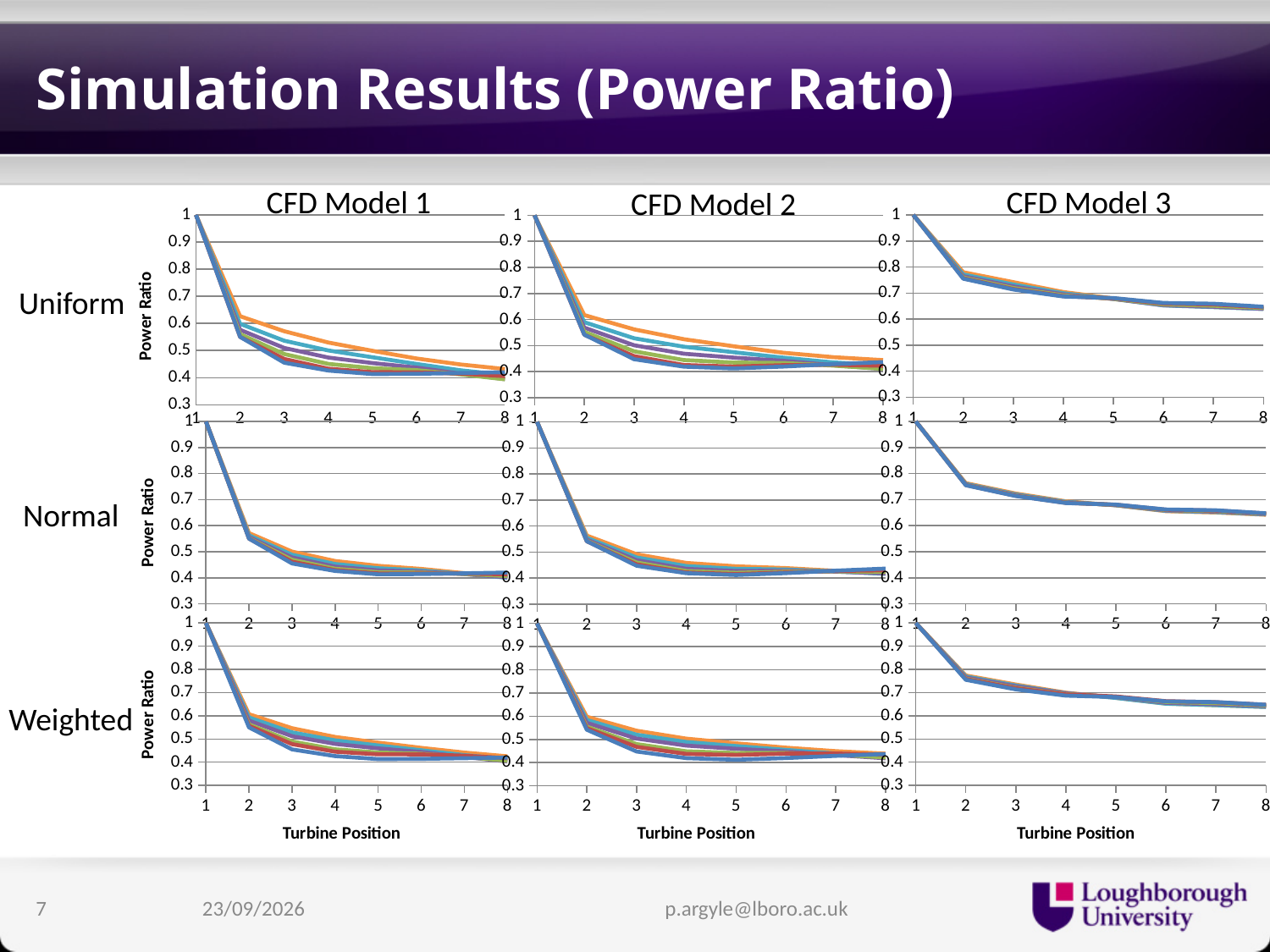
In the Normal / CFD Model 1 chart, do the power ratio values rise or fall as turbine position increases? fall In the Weighted / CFD Model 3 chart, is the power ratio at turbine position 8 greater or less than 0.6? greater What is the x-axis title shown under the Weighted row of charts? Turbine Position In the Uniform / CFD Model 1 chart, is the power ratio at turbine position 8 greater or less than 0.5? less How many turbine positions are shown on the x axis of the Weighted / CFD Model 2 chart? 8 At turbine position 8, which chart shows the larger power ratio: Uniform / CFD Model 1 or Uniform / CFD Model 3? Uniform / CFD Model 3 In the Normal / CFD Model 2 chart, is the power ratio at turbine position 3 greater or less than 0.6? less In the Weighted / CFD Model 1 chart, at which turbine position is the power ratio highest? 1 In the Uniform / CFD Model 3 chart, what is the power ratio at turbine position 1? 1 What is the y-axis title on the charts in the Normal row? Power Ratio What kind of chart is used in the Uniform / CFD Model 1 panel? line chart